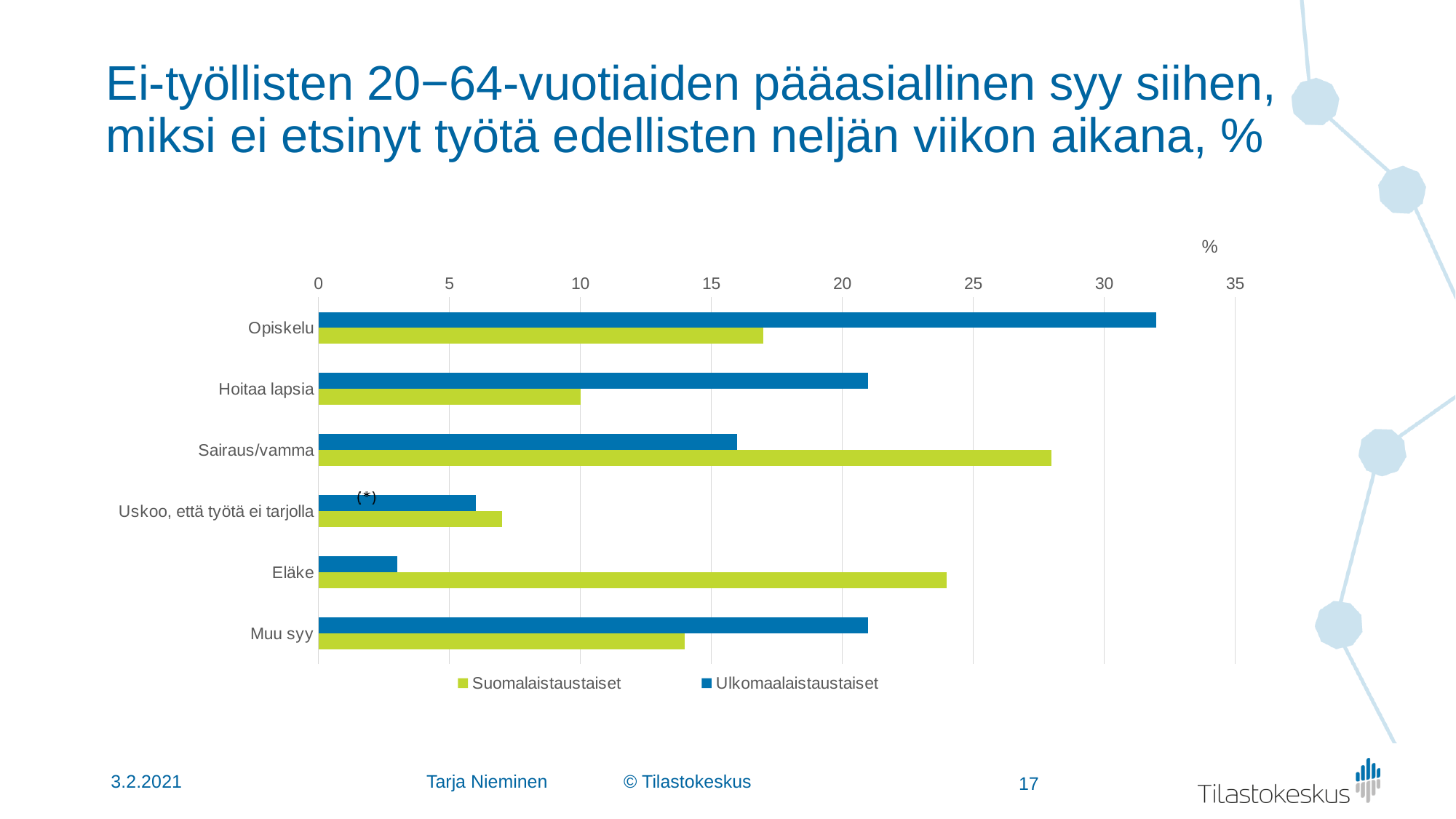
How many categories (reasons) are shown on the vertical axis? 6 How many series does the legend list? 2 Is the Ulkomaalaistaustaiset value for Opiskelu greater or less than 30? greater For the Ulkomaalaistaustaiset series, which category has the highest value? Opiskelu For Muu syy, which series has the larger value, Suomalaistaustaiset or Ulkomaalaistaustaiset? Ulkomaalaistaustaiset For the Suomalaistaustaiset series, which category has the lowest value? Uskoo, että työtä ei tarjolla Is the Suomalaistaustaiset value for Eläke greater or less than 25? less What colour represents the Suomalaistaustaiset series in the legend? green For the Ulkomaalaistaustaiset series, which category has the lowest value? Eläke For the Suomalaistaustaiset series, which category has the highest value? Sairaus/vamma For Sairaus/vamma, which series has the larger value, Suomalaistaustaiset or Ulkomaalaistaustaiset? Suomalaistaustaiset What kind of chart is shown on the slide? bar chart